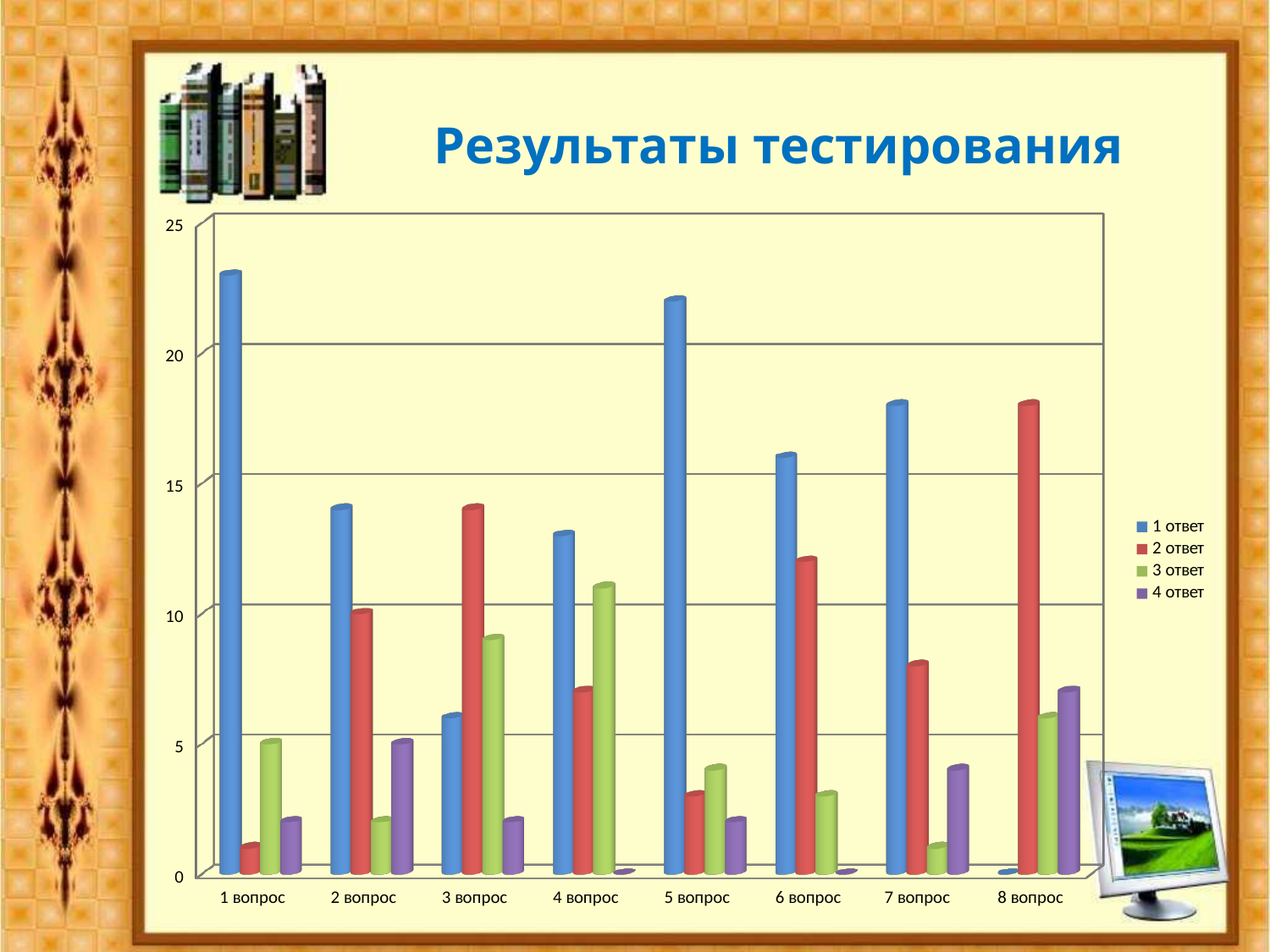
Is the value for "1 ответ" at "1 вопрос" greater or less than 20? greater What is the title of the slide containing the chart? Результаты тестирования Is the value for "1 ответ" at "5 вопрос" greater or less than 20? greater At "3 вопрос", which answer series has the highest bar? 2 ответ Which question has the lowest bar for "1 ответ"? 8 вопрос How many series does the chart's legend list? 4 How many questions (categories) are shown along the x axis of the chart? 8 What kind of chart is shown on the slide? bar chart At "6 вопрос", which is larger: "1 ответ" or "2 ответ"? 1 ответ Which question has the highest bar for "2 ответ"? 8 вопрос Is the value for "2 ответ" at "3 вопрос" greater or less than 10? greater At "4 вопрос", which is larger: "2 ответ" or "3 ответ"? 3 ответ